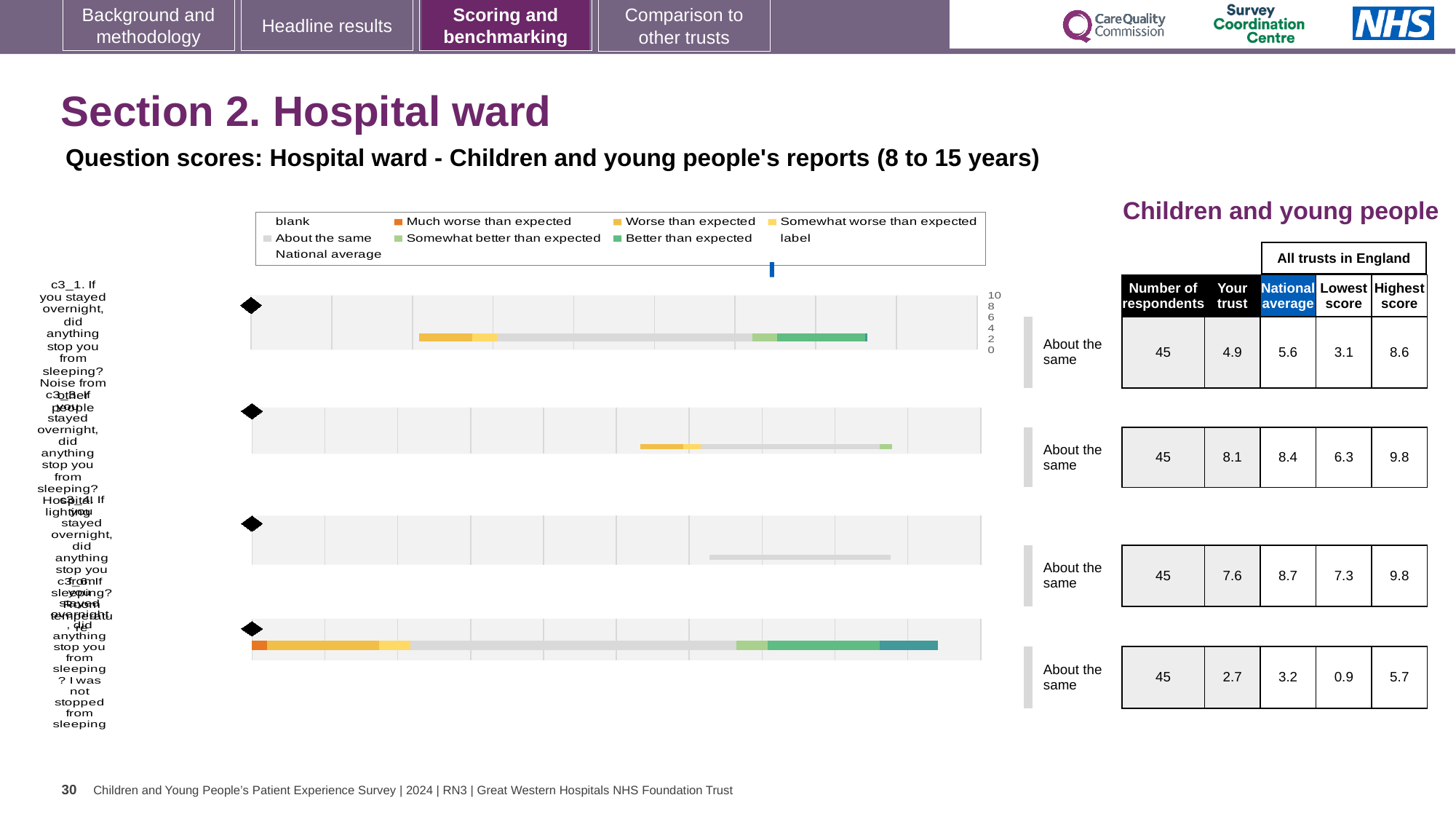
For the bottom chart (c3_6), what is the highest score among all trusts in England? 5.7 For the top chart (c3_1, noise from other people), what is the 'Your trust' score shown in the table? 4.9 How many benchmark bar charts are shown on the slide? 4 For the third chart from the top (c3_4), what is the difference between the national average and the 'Your trust' score? 1.1 For the second chart from the top (c3_3, hospital lighting), what is the national average score? 8.4 For the top chart (c3_1), which is larger: the 'Your trust' score or the national average? National average What benchmark label is shown next to each of the four charts? About the same What kind of chart is used on this slide to show the question scores? Bar chart Which of the four charts has the highest 'Your trust' score? The second chart from the top (c3_3), 8.1 How many respondents are listed for the top chart (c3_1)? 45 For the bottom chart (c3_6), what is the lowest score among all trusts in England? 0.9 Which of the four charts has the lowest 'Your trust' score? The bottom chart (c3_6), 2.7